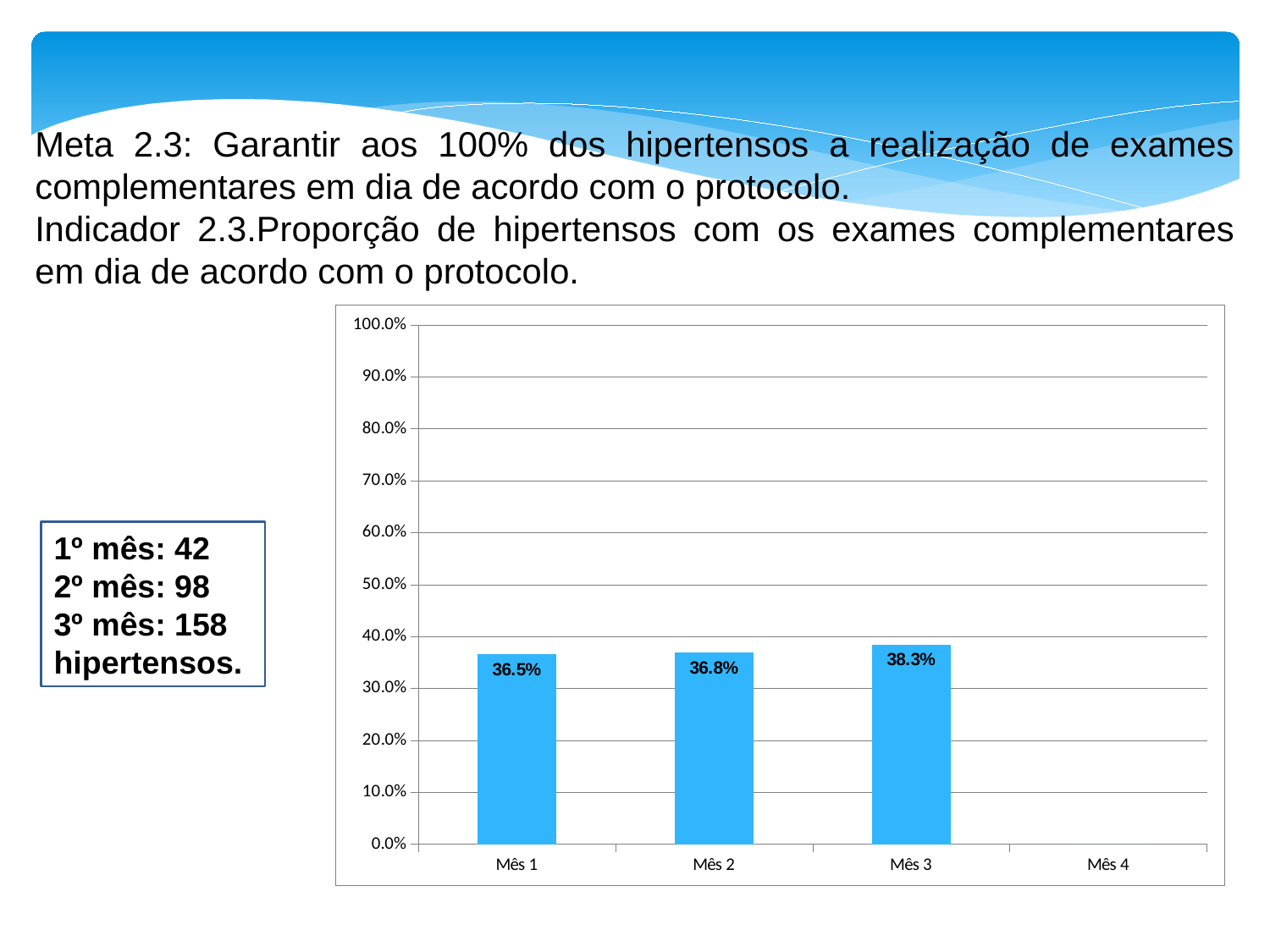
What is the value for Mês 2? 36.8% Is the value for Mês 3 greater or less than 40.0%? less How many month categories are shown on the x axis? 4 Do the values rise or fall from Mês 1 to Mês 3? Rise What kind of chart is shown on the slide? Bar chart What is the difference between the values for Mês 2 and Mês 1? 0.3% What is the difference between the values for Mês 3 and Mês 1? 1.8% Among the months with a plotted bar, which has the lowest value? Mês 1 Which month has the highest value? Mês 3 What is the value for Mês 1? 36.5% Is the value for Mês 1 greater or less than 30.0%? greater What is the value for Mês 3? 38.3%